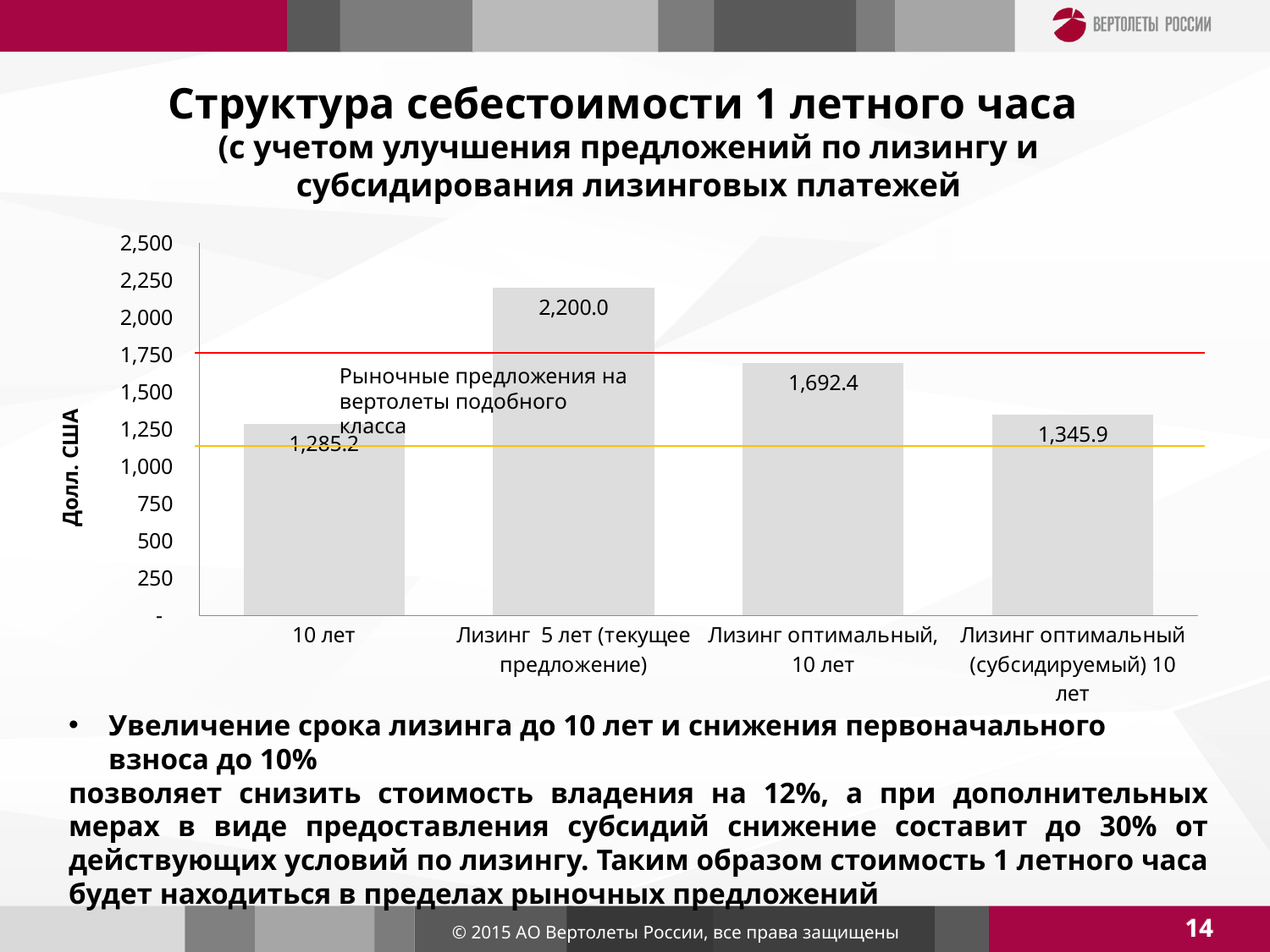
Is the value for "Лизинг оптимальный, 10 лет" greater or less than 1,500? greater What is the label of the vertical axis? Долл. США Which category has the lowest value? 10 лет What is the difference between the values for "Лизинг 5 лет (текущее предложение)" and "Лизинг оптимальный, 10 лет"? 507.6 How many categories are shown on the x axis? 4 Which category has the highest value? Лизинг 5 лет (текущее предложение) What kind of chart is shown on the slide? bar chart Which is larger: the value for "Лизинг оптимальный (субсидируемый) 10 лет" or the value for "10 лет"? Лизинг оптимальный (субсидируемый) 10 лет What is the value for "Лизинг оптимальный (субсидируемый) 10 лет"? 1,345.9 What is the value for "Лизинг 5 лет (текущее предложение)"? 2,200.0 What is the value for "Лизинг оптимальный, 10 лет"? 1,692.4 What is the value for "10 лет"? 1,285.2